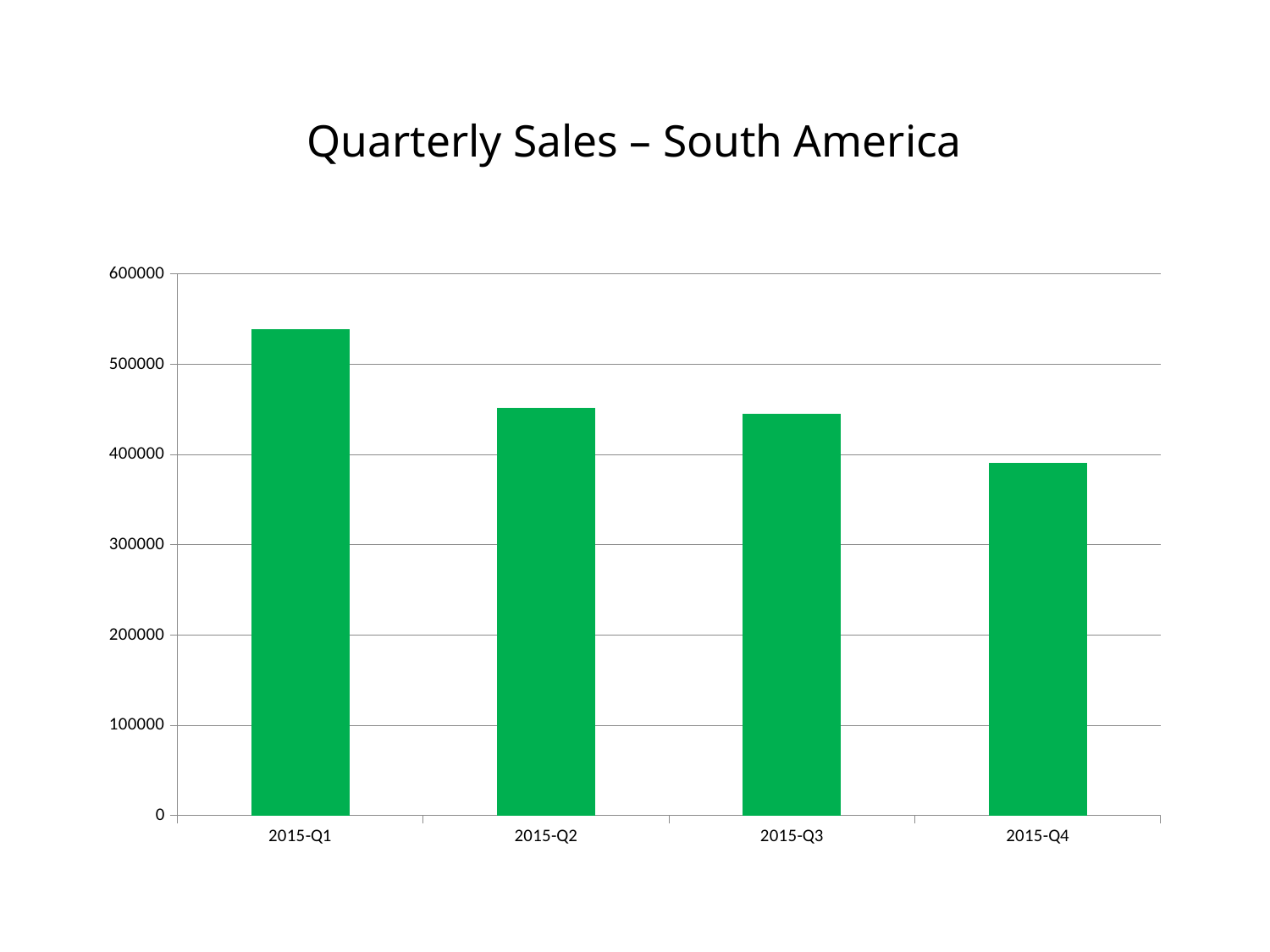
Is the value for 2015-Q3 greater or less than 500000? less What is the title of the chart? Quarterly Sales – South America Which quarter has the lowest sales? 2015-Q4 Which quarter has the highest sales? 2015-Q1 Do the sales values rise or fall from 2015-Q1 to 2015-Q4? fall Is the value for 2015-Q1 greater or less than 500000? greater Is the value for 2015-Q4 greater or less than 400000? less What kind of chart is shown on the slide? bar chart Which is larger, the value for 2015-Q1 or the value for 2015-Q4? 2015-Q1 Which is larger, the value for 2015-Q2 or the value for 2015-Q4? 2015-Q2 How many quarters are plotted on the chart? 4